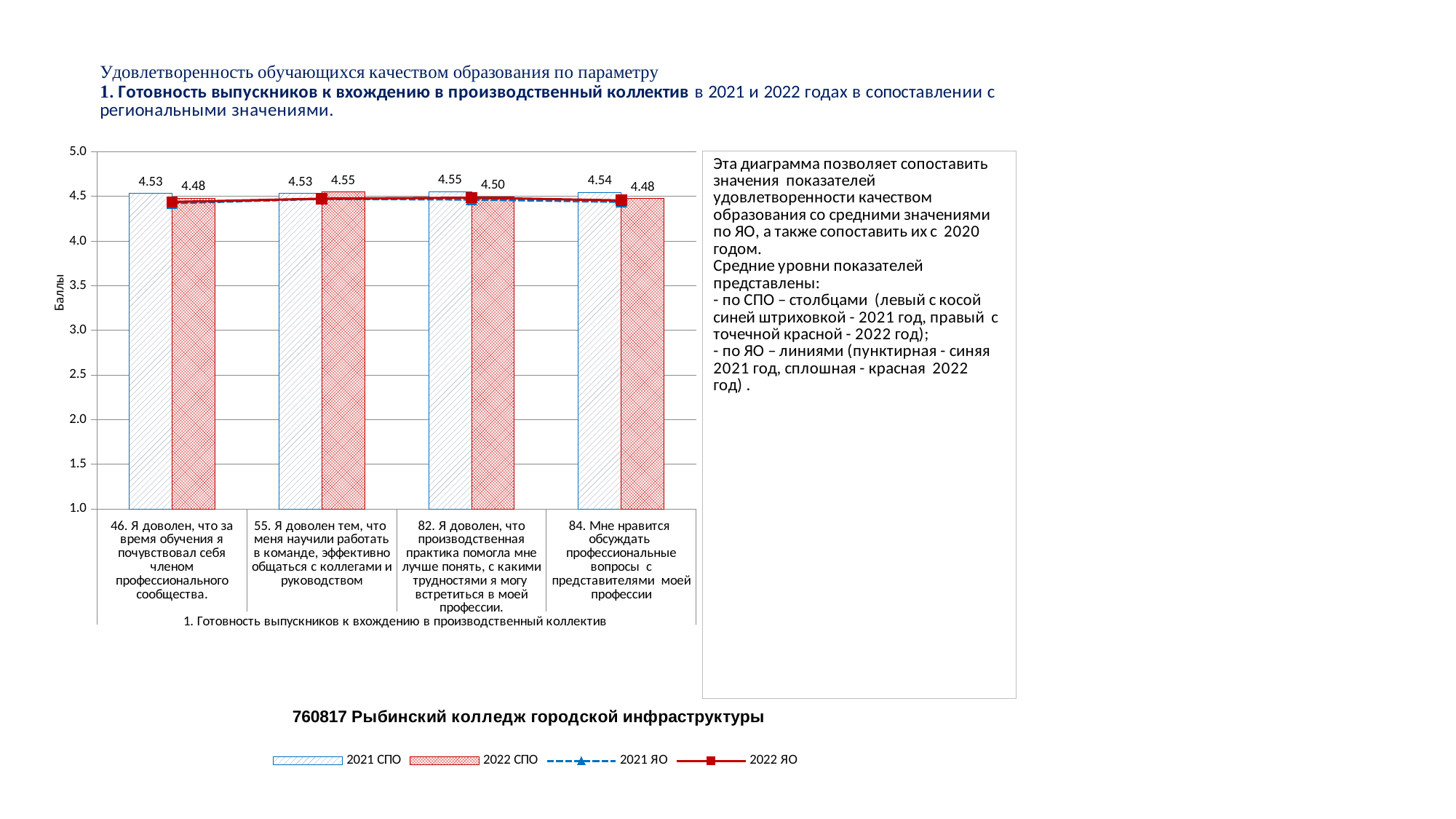
What is the difference between the 2021 СПО and 2022 СПО values for item 84? 0.06 How many series does the chart legend list? 4 Is the 2022 ЯО line value for item 46 greater or less than 4.0? greater What is the value of the 2022 СПО bar for item 55 (Я доволен тем, что меня научили работать в команде)? 4.55 What is the value of the 2022 СПО bar for item 82 (производственная практика помогла мне лучше понять...)? 4.50 What is the title of the vertical axis of the chart? Баллы How many items (categories) are shown on the x axis of the chart? 4 What is the difference between the 2021 СПО and 2022 СПО values for item 46? 0.05 What is the value of the 2021 СПО bar for item 46 (Я доволен, что за время обучения я почувствовал себя членом профессионального сообщества)? 4.53 For which item is the 2022 СПО bar the highest? 55. Я доволен тем, что меня научили работать в команде, эффективно общаться с коллегами и руководством What is the value of the 2021 СПО bar for item 84 (Мне нравится обсуждать профессиональные вопросы...)? 4.54 For item 55, which is larger: the 2021 СПО value or the 2022 СПО value? 2022 СПО